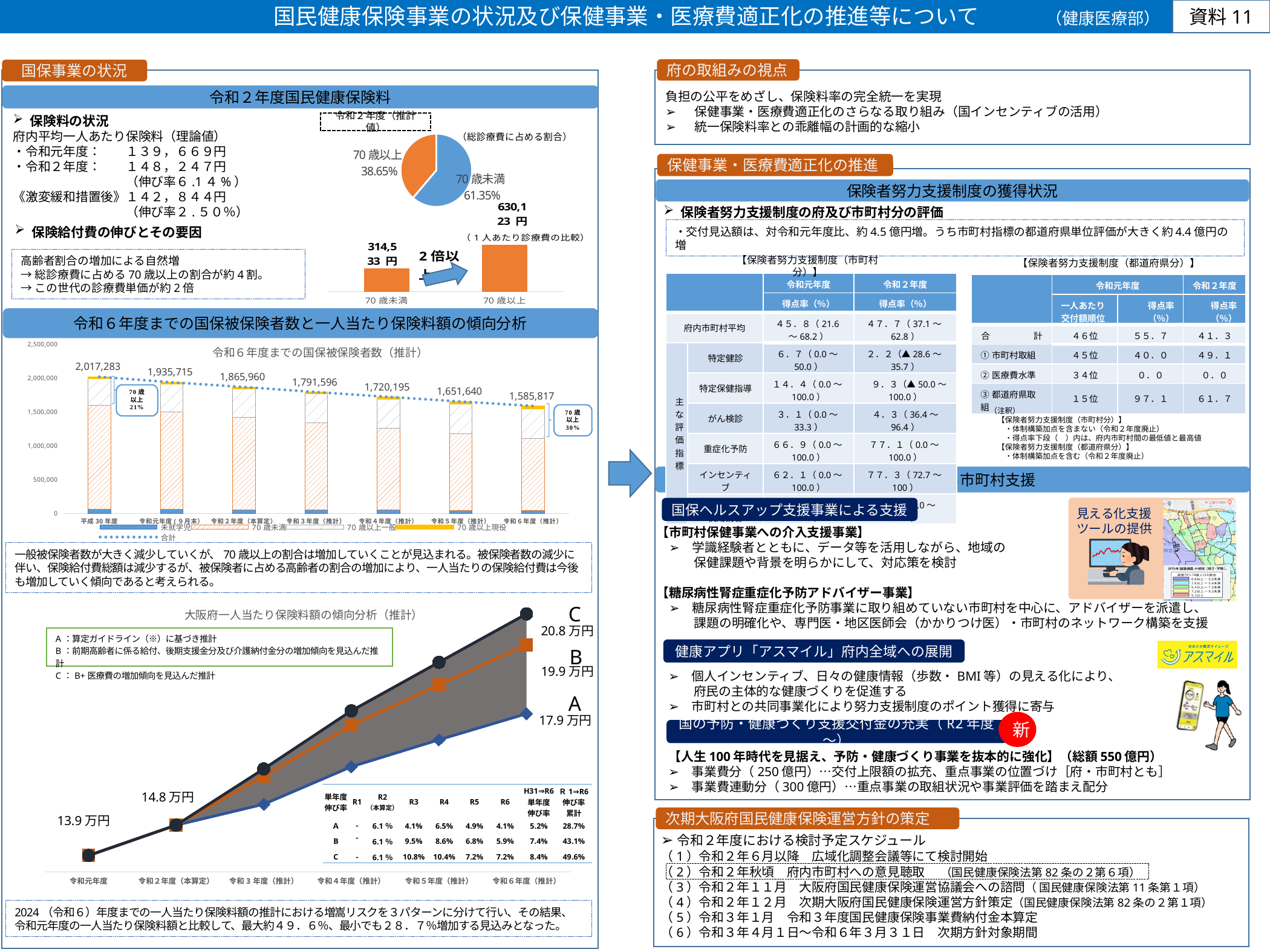
In the chart 令和6年度までの国保被保険者数（推計）, how many fiscal years are plotted on the x axis? 7 In the chart 大阪府一人当たり保険料額の傾向分析（推計）, which of the three estimates A, B or C ends highest in 令和6年度? C In the pie chart 総診療費に占める割合, what share is labelled for 70歳未満? 61.35% In the pie chart 総診療費に占める割合, what share is labelled for 70歳以上? 38.65% In the chart 令和6年度までの国保被保険者数（推計）, what is the difference between the totals for 平成30年度 and 令和元年度? 81,568 In the chart 令和6年度までの国保被保険者数（推計）, do the total values rise or fall from 平成30年度 to 令和6年度? fall In the bar chart 1人当たり診療費の比較, what is the value for 70歳未満? 314,533円 In the bar chart 1人当たり診療費の比較, what is the value for 70歳以上? 630,123円 In the pie chart 総診療費に占める割合, which slice is larger, 70歳以上 or 70歳未満? 70歳未満 In the chart 令和6年度までの国保被保険者数（推計）, what is the total labelled for 令和6年度（推計）? 1,585,817 In the chart 令和6年度までの国保被保険者数（推計）, what is the total labelled for 平成30年度? 2,017,283 In the chart 大阪府一人当たり保険料額の傾向分析（推計）, what is the value labelled for 令和元年度? 13.9万円